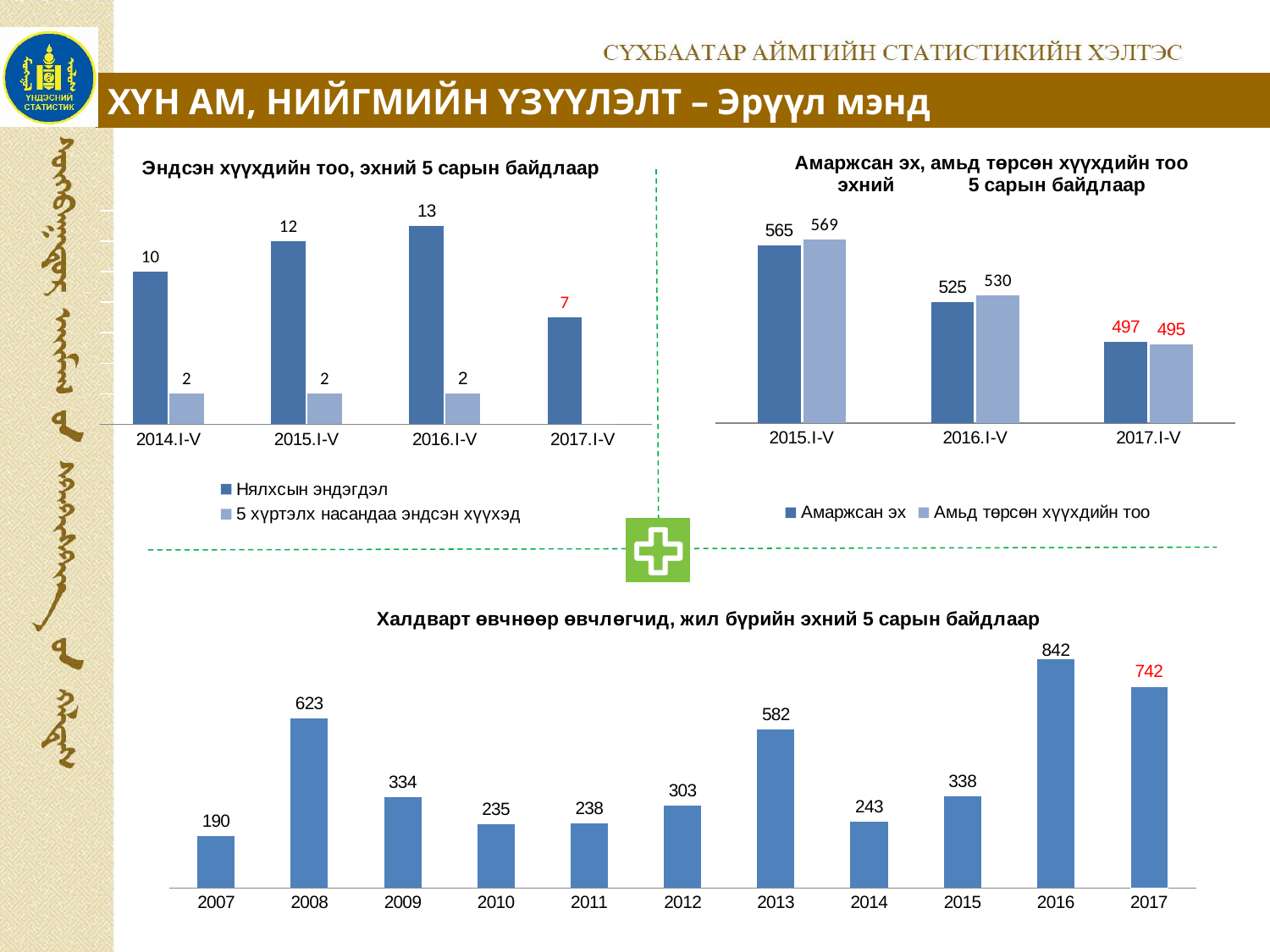
In the bottom chart (Халдварт өвчнөөр өвчлөгчид), what is the value for 2013? 582 In the top-left chart (Эндсэн хүүхдийн тоо), what is the value of Нялхсын эндэгдэл for 2016.I-V? 13 In the top-right chart (Амаржсан эх, амьд төрсөн хүүхдийн тоо), what is the value of Амьд төрсөн хүүхдийн тоо for 2016.I-V? 530 In the top-right chart (Амаржсан эх, амьд төрсөн хүүхдийн тоо), what is the value of Амаржсан эх for 2017.I-V? 497 In the bottom chart (Халдварт өвчнөөр өвчлөгчид), which year has the highest value? 2016 In the top-left chart (Эндсэн хүүхдийн тоо), what is the difference between the Нялхсын эндэгдэл values for 2016.I-V and 2017.I-V? 6 In the top-right chart (Амаржсан эх, амьд төрсөн хүүхдийн тоо), what is the difference between Амаржсан эх for 2015.I-V and 2016.I-V? 40 In the top-left chart (Эндсэн хүүхдийн тоо), which period has the lowest value for Нялхсын эндэгдэл? 2017.I-V In the bottom chart (Халдварт өвчнөөр өвчлөгчид), how many years are shown on the x axis? 11 In the top-right chart (Амаржсан эх, амьд төрсөн хүүхдийн тоо), do the Амаржсан эх values rise or fall from 2015.I-V to 2017.I-V? fall In the top-left chart (Эндсэн хүүхдийн тоо), how many series does the legend list? 2 In the bottom chart (Халдварт өвчнөөр өвчлөгчид), which is larger, the value for 2008 or the value for 2017? 2017